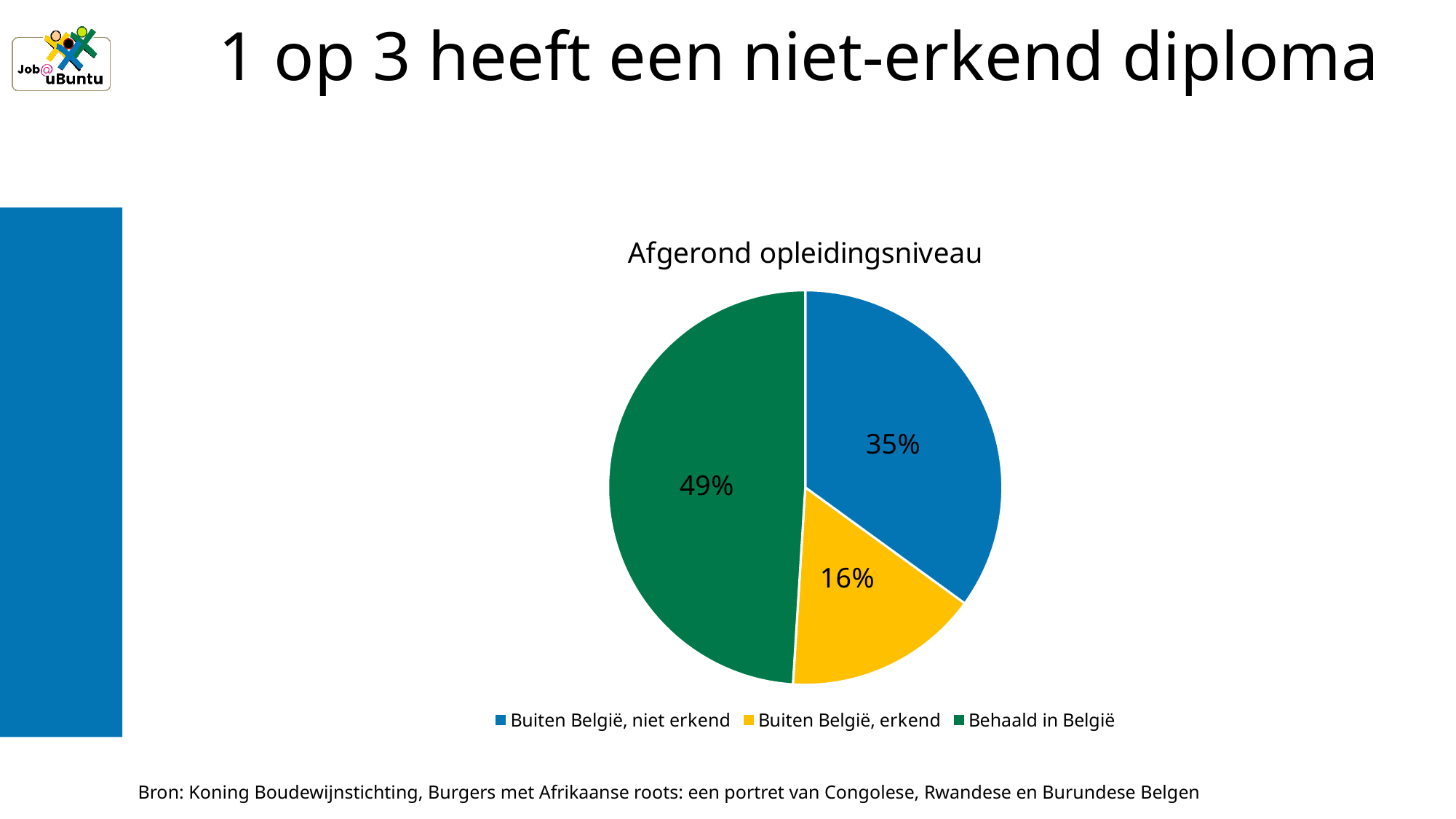
What is the difference in percentage points between "Behaald in België" and "Buiten België, niet erkend"? 14 Which category has the largest slice of the pie? Behaald in België What is the difference in percentage points between "Buiten België, niet erkend" and "Buiten België, erkend"? 19 Which colour represents "Behaald in België" in the chart? Green What is the title of the chart? Afgerond opleidingsniveau What share of the pie does "Behaald in België" represent? 49% How many categories does the pie chart show? 3 What share of the pie does "Buiten België, erkend" represent? 16% What share of the pie does "Buiten België, niet erkend" represent? 35% Which category has the smallest slice of the pie? Buiten België, erkend Which is larger: "Buiten België, niet erkend" or "Buiten België, erkend"? Buiten België, niet erkend What kind of chart is shown on the slide? Pie chart